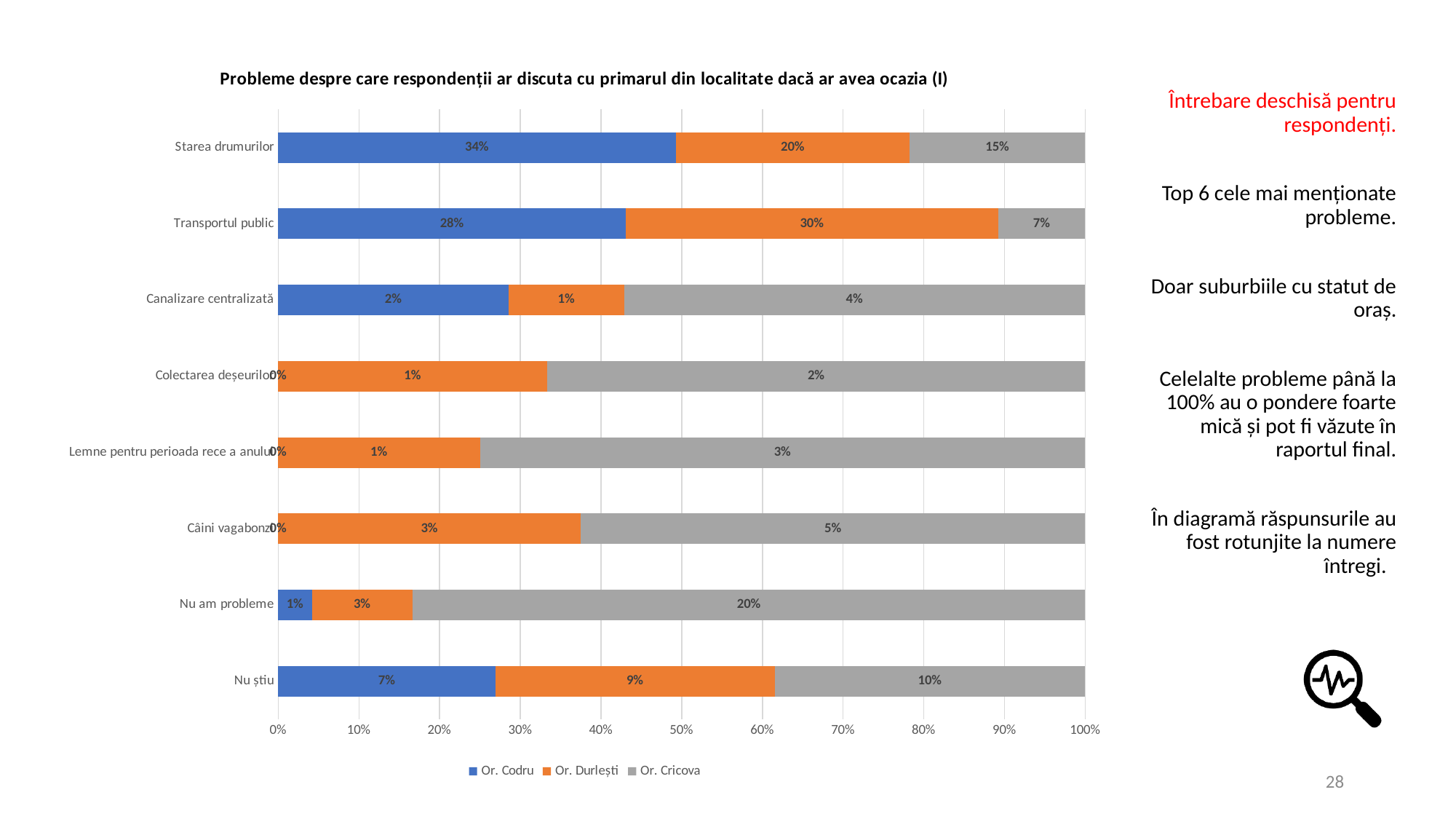
What is the difference between the Or. Codru and Or. Cricova values for 'Starea drumurilor'? 19 percentage points What is the value for Or. Cricova for 'Câini vagabonzi'? 5% What is the value for Or. Codru for 'Starea drumurilor'? 34% What is the value for Or. Durlești for 'Transportul public'? 30% Which category has the highest value for Or. Cricova? Nu am probleme Which category has the lowest value for Or. Cricova? Colectarea deșeurilor Which category has the highest value for Or. Codru? Starea drumurilor How many problem categories are shown on the chart? 8 What kind of chart is shown on the slide? Stacked bar chart How many series does the legend list? 3 For 'Nu știu', which is larger: the value for Or. Codru or for Or. Cricova? Or. Cricova What is the value for Or. Cricova for 'Nu am probleme'? 20%